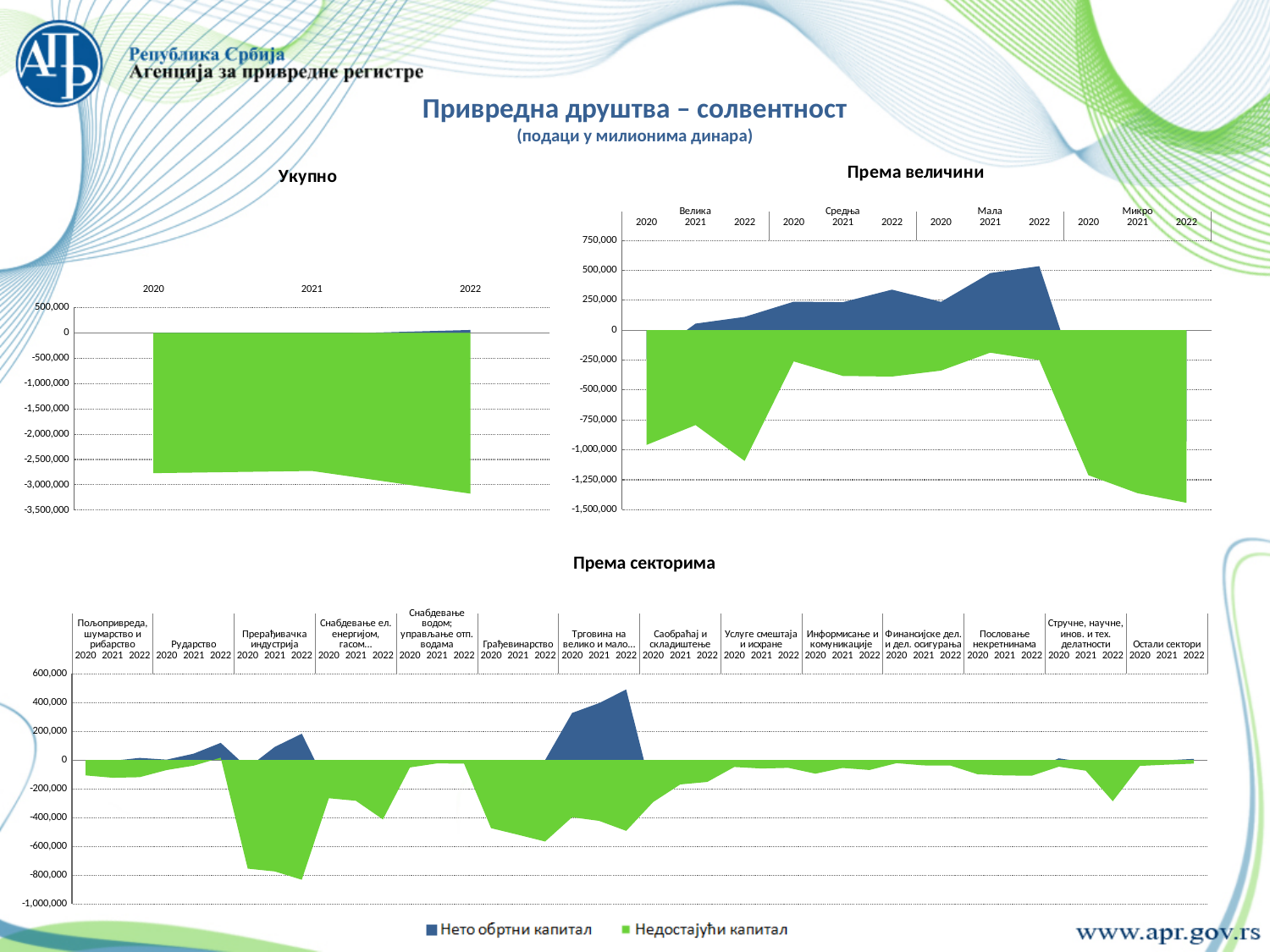
How many series does the legend at the bottom of the slide list? 2 In the "Укупно" chart, how many years are shown on the x axis? 3 In the "Према секторима" chart, is the value of Недостајући капитал for Прерађивачка индустрија in 2022 greater or less than -600,000? less In the "Према величини" chart, is the value of Нето обртни капитал for Мала in 2022 greater or less than 250,000? greater In the "Укупно" chart, is the value of Недостајући капитал for 2022 greater or less than -3,000,000? less In the "Према секторима" chart, which sector has the highest value of Нето обртни капитал? Трговина на велико и мало What are the two series named in the legend? Нето обртни капитал and Недостајући капитал What type of chart is the "Укупно" chart? Area chart In the "Према величини" chart, does Недостајући капитал for Микро rise or fall from 2020 to 2022? fall In the "Према величини" chart, how many size categories are shown? 4